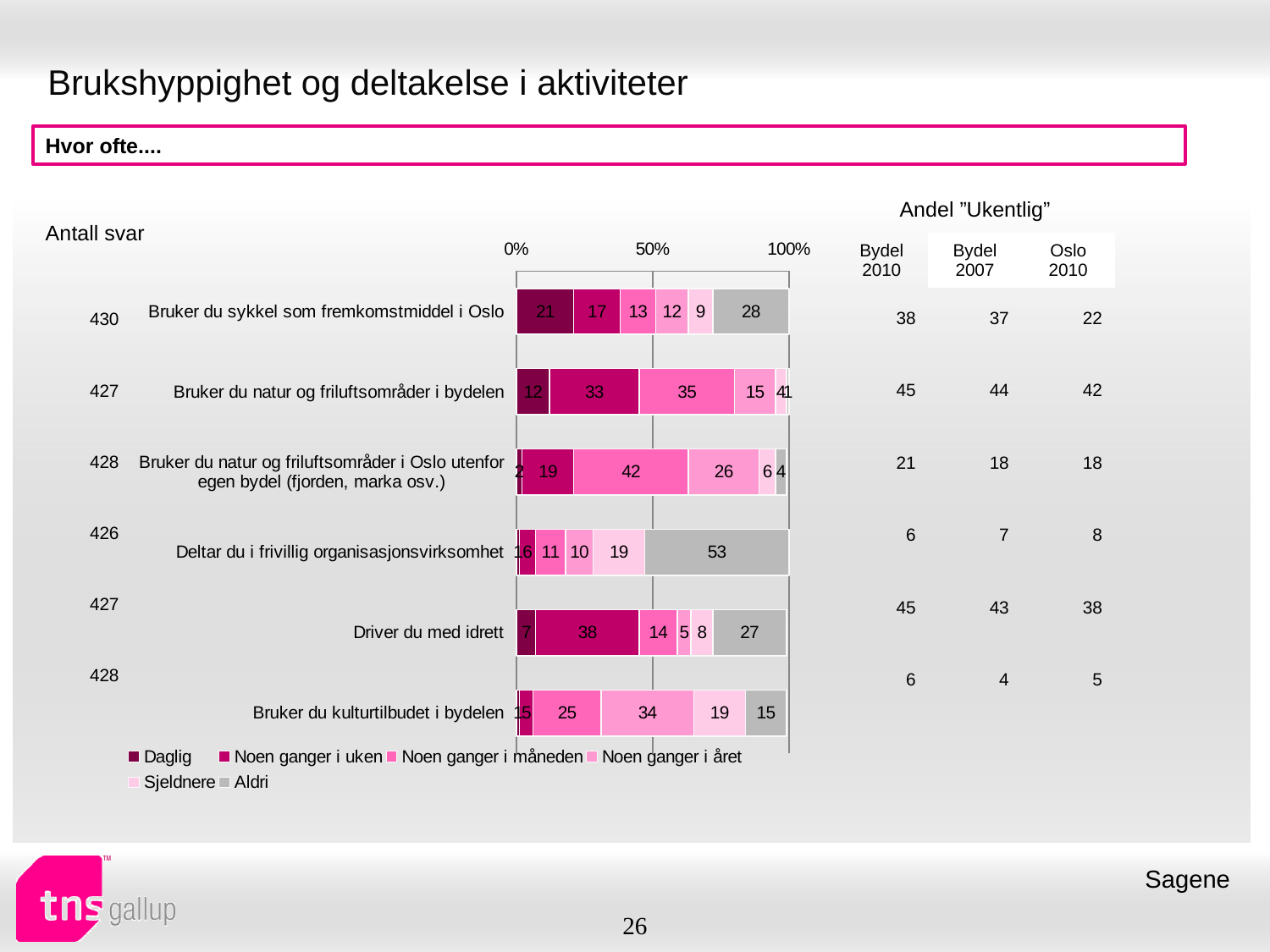
What is the "Noen ganger i uken" value for "Driver du med idrett"? 38 Which category has the highest "Aldri" value? Deltar du i frivillig organisasjonsvirksomhet What is the "Noen ganger i året" value for "Bruker du kulturtilbudet i bydelen"? 34 Which is larger: the "Daglig" value for "Bruker du sykkel som fremkomstmiddel i Oslo" or for "Bruker du natur og friluftsområder i bydelen"? Bruker du sykkel som fremkomstmiddel i Oslo What is the difference between the "Aldri" values for "Deltar du i frivillig organisasjonsvirksomhet" and "Driver du med idrett"? 26 What is the first series listed in the chart legend? Daglig What kind of chart is shown on the slide? bar chart What is the "Aldri" value for "Deltar du i frivillig organisasjonsvirksomhet"? 53 How many activity categories are plotted in the chart? 6 How many series does the chart legend list? 6 What is the "Noen ganger i måneden" value for "Bruker du natur og friluftsområder i Oslo utenfor egen bydel (fjorden, marka osv.)"? 42 What is the "Aldri" value for "Bruker du sykkel som fremkomstmiddel i Oslo"? 28